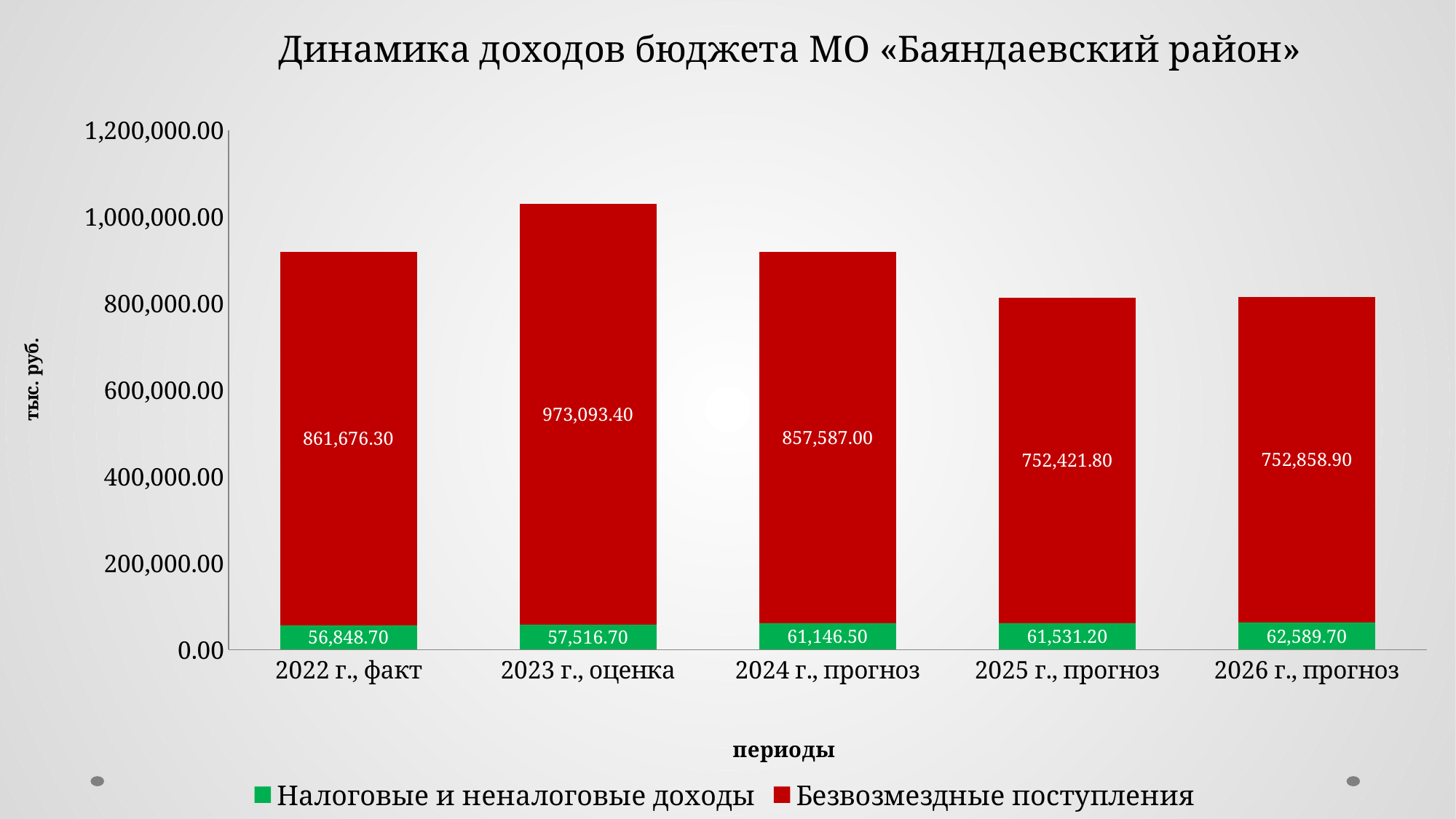
Do the values of «Налоговые и неналоговые доходы» rise or fall from 2022 to 2026? rise Which period has the highest value of «Безвозмездные поступления»? 2023 г., оценка What kind of chart is shown on the slide? stacked bar chart Is the total height of the stacked bar for «2023 г., оценка» greater or less than 1,000,000.00? greater How many series does the legend list? 2 How many periods are shown on the x axis? 5 What is the value of «Налоговые и неналоговые доходы» for «2025 г., прогноз»? 61,531.20 What is the difference between «Безвозмездные поступления» for «2023 г., оценка» and for «2022 г., факт»? 111,417.10 Which period has the lowest value of «Налоговые и неналоговые доходы»? 2022 г., факт Which is larger: «Безвозмездные поступления» for «2024 г., прогноз» or for «2025 г., прогноз»? 2024 г., прогноз What is the value of «Безвозмездные поступления» for «2023 г., оценка»? 973,093.40 What is the total of the stacked bar for «2025 г., прогноз»? 813,953.00